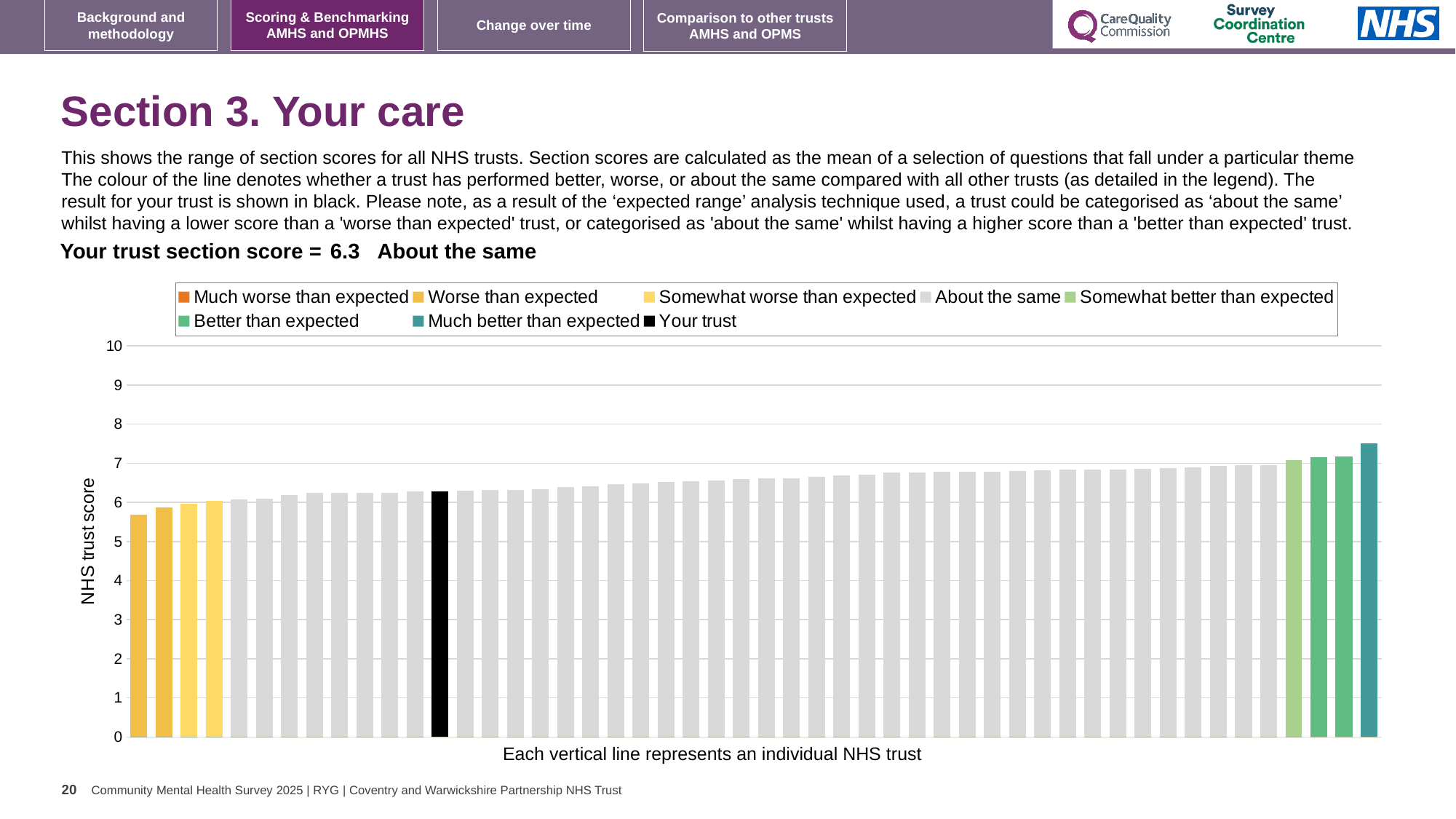
What is the label on the vertical axis of the chart? NHS trust score Is the value of the shortest bar greater or less than 6? less What is the section score for your trust shown on the slide? 6.3 Is the value of the tallest bar greater or less than 8? less Do the bar values rise or fall from left to right along the x axis? rise Which performance category is your trust placed in for Section 3? About the same How many entries does the chart legend list? 8 Is the value of the tallest bar greater or less than 7? greater What kind of chart is shown on the slide? bar chart Which legend category does the tallest bar belong to, based on its colour? Much better than expected What colour is the bar representing your trust? black